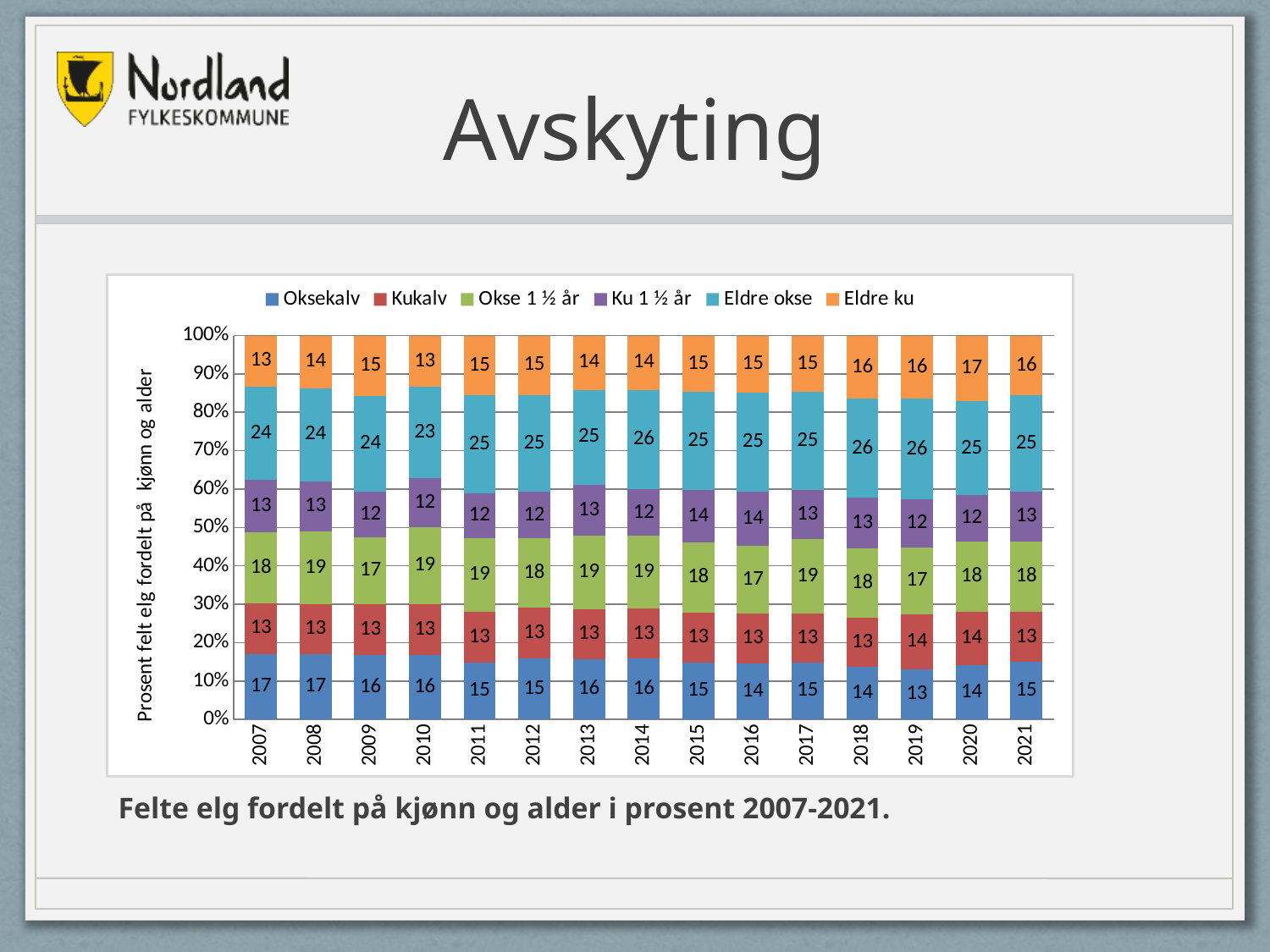
Which is larger in 2009: the Okse 1 ½ år value or the Eldre ku value? Okse 1 ½ år Does the Eldre ku value rise or fall overall from 2007 to 2021? Rise What is the label of the y axis? Prosent felt elg fordelt på kjønn og alder In which year is the Oksekalv value lowest? 2019 What is the value for Eldre okse in 2014? 26 What is the value for Oksekalv in 2007? 17 How many years are shown on the x axis? 15 What is the value for Ku 1 ½ år in 2016? 14 What is the difference between the Eldre okse value and the Oksekalv value in 2021? 10 In which year is the Eldre ku value highest? 2020 How many series does the legend list? 6 What kind of chart is shown on the slide? Stacked bar chart